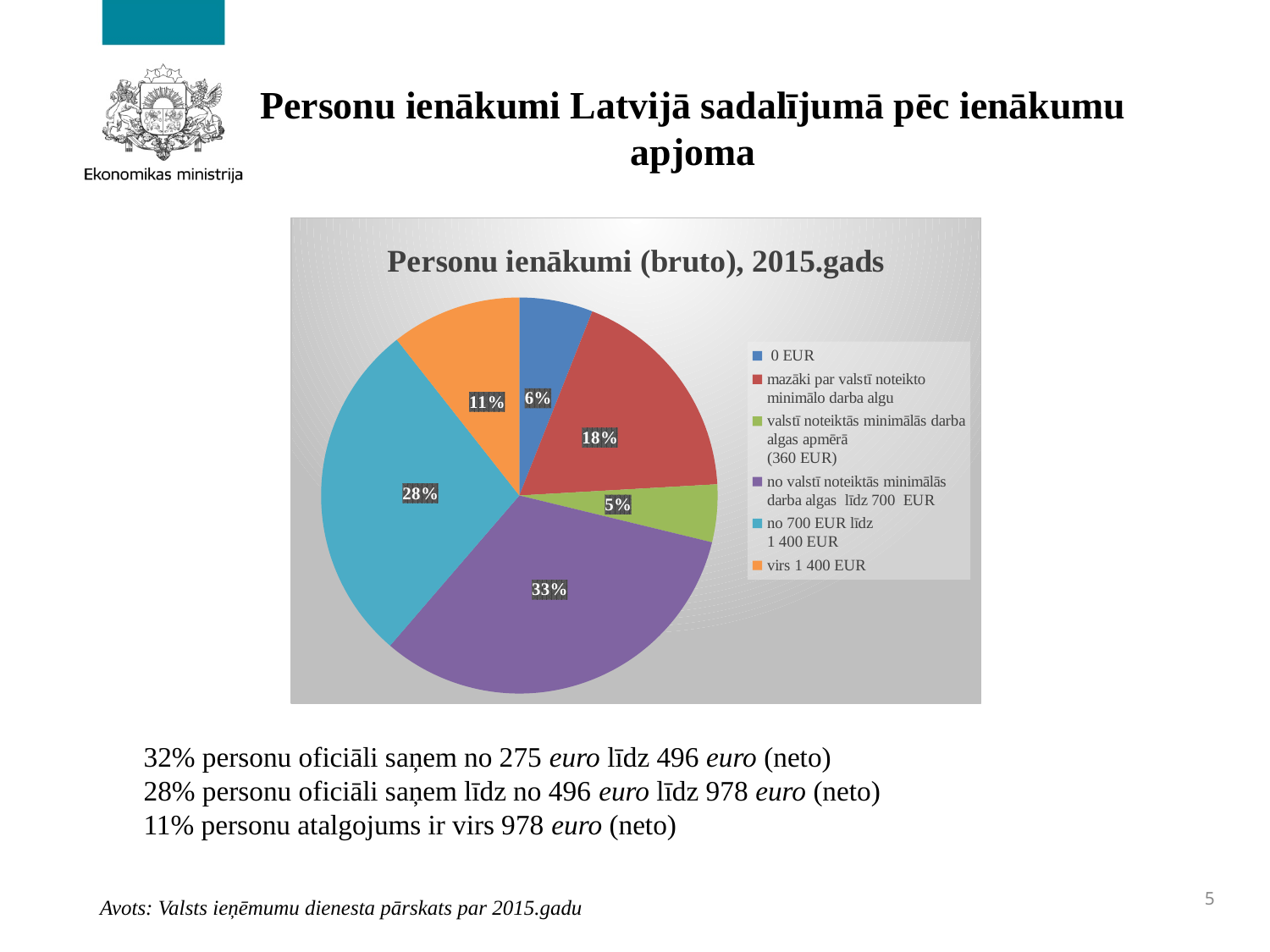
What percentage is shown for "no 700 EUR līdz 1 400 EUR"? 28% Which category has the largest share of the pie? no valstī noteiktās minimālās darba algas līdz 700 EUR Which is larger: the share for "mazāki par valstī noteikto minimālo darba algu" or the share for "virs 1 400 EUR"? mazāki par valstī noteikto minimālo darba algu What percentage is shown for "virs 1 400 EUR"? 11% What percentage is shown for "valstī noteiktās minimālās darba algas apmērā (360 EUR)"? 5% How many slices does the pie chart have? 6 What type of chart is shown on the slide? Pie chart What percentage is shown for "mazāki par valstī noteikto minimālo darba algu"? 18% What is the difference in percentage points between "no valstī noteiktās minimālās darba algas līdz 700 EUR" and "no 700 EUR līdz 1 400 EUR"? 5 percentage points What is the title of the chart? Personu ienākumi (bruto), 2015.gads Which category has the smallest share of the pie? valstī noteiktās minimālās darba algas apmērā (360 EUR) What share of the pie is labelled "0 EUR"? 6%